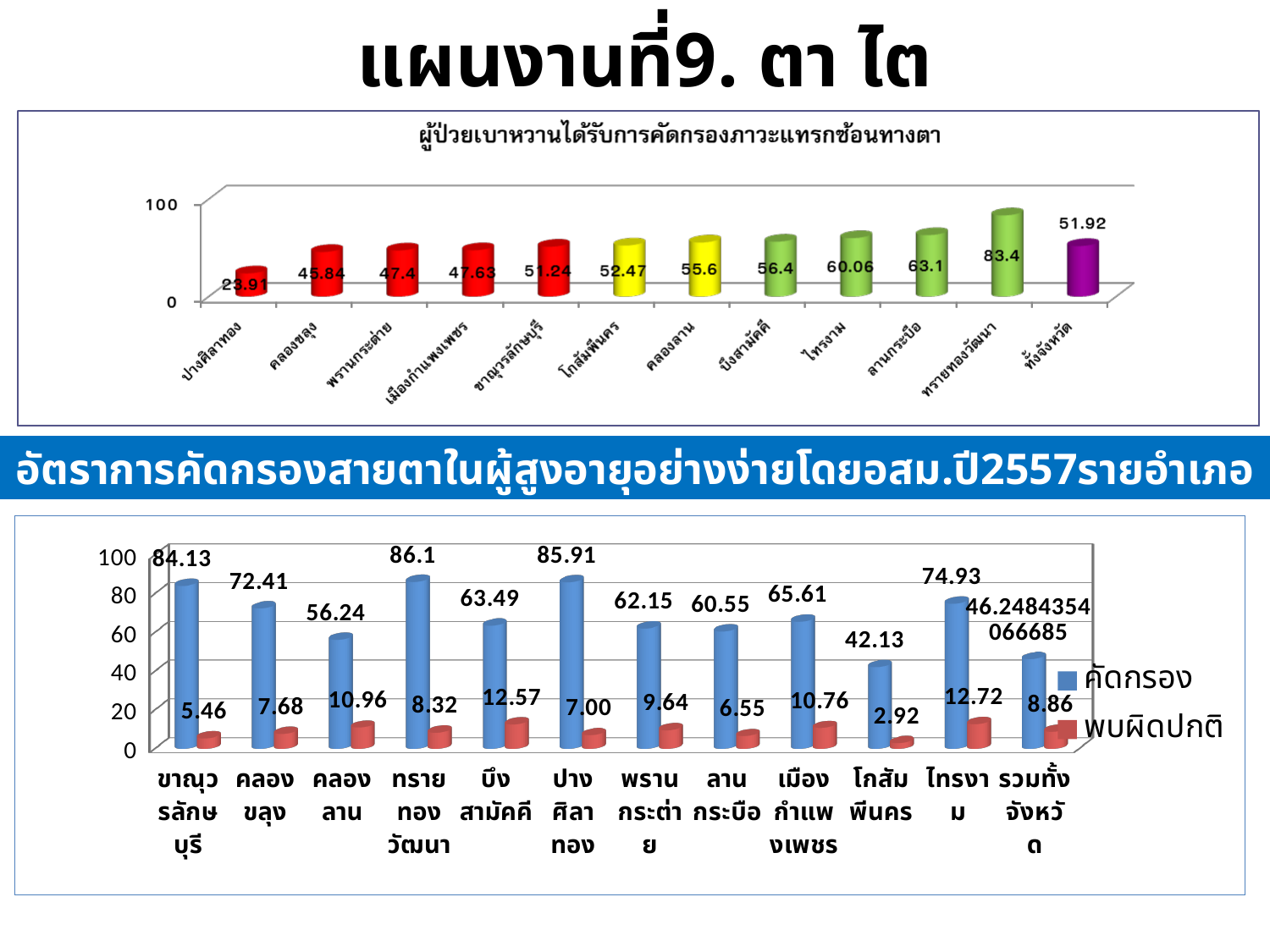
In the top chart, how many categories are shown on the x axis? 12 In the top chart, what is the difference between the values for ลานกระบือ and ไทรงาม? 3.04 In the bottom chart, how many series does the legend list? 2 In the top chart, what is the value for ทั้งจังหวัด? 51.92 In the top chart, which category has the lowest value? ปางศิลาทอง In the bottom chart, what is the คัดกรอง value for ทรายทองวัฒนา? 86.1 What kind of chart is the bottom chart? bar chart In the top chart, what is the value for ทรายทองวัฒนา? 83.4 In the bottom chart, is the คัดกรอง value for ขาณุวรลักษบุรี larger or smaller than that for คลองขลุง? larger In the top chart, which category has the highest value? ทรายทองวัฒนา In the bottom chart, which category has the highest พบผิดปกติ value? ไทรงาม In the bottom chart, what is the พบผิดปกติ value for โกสัมพีนคร? 2.92